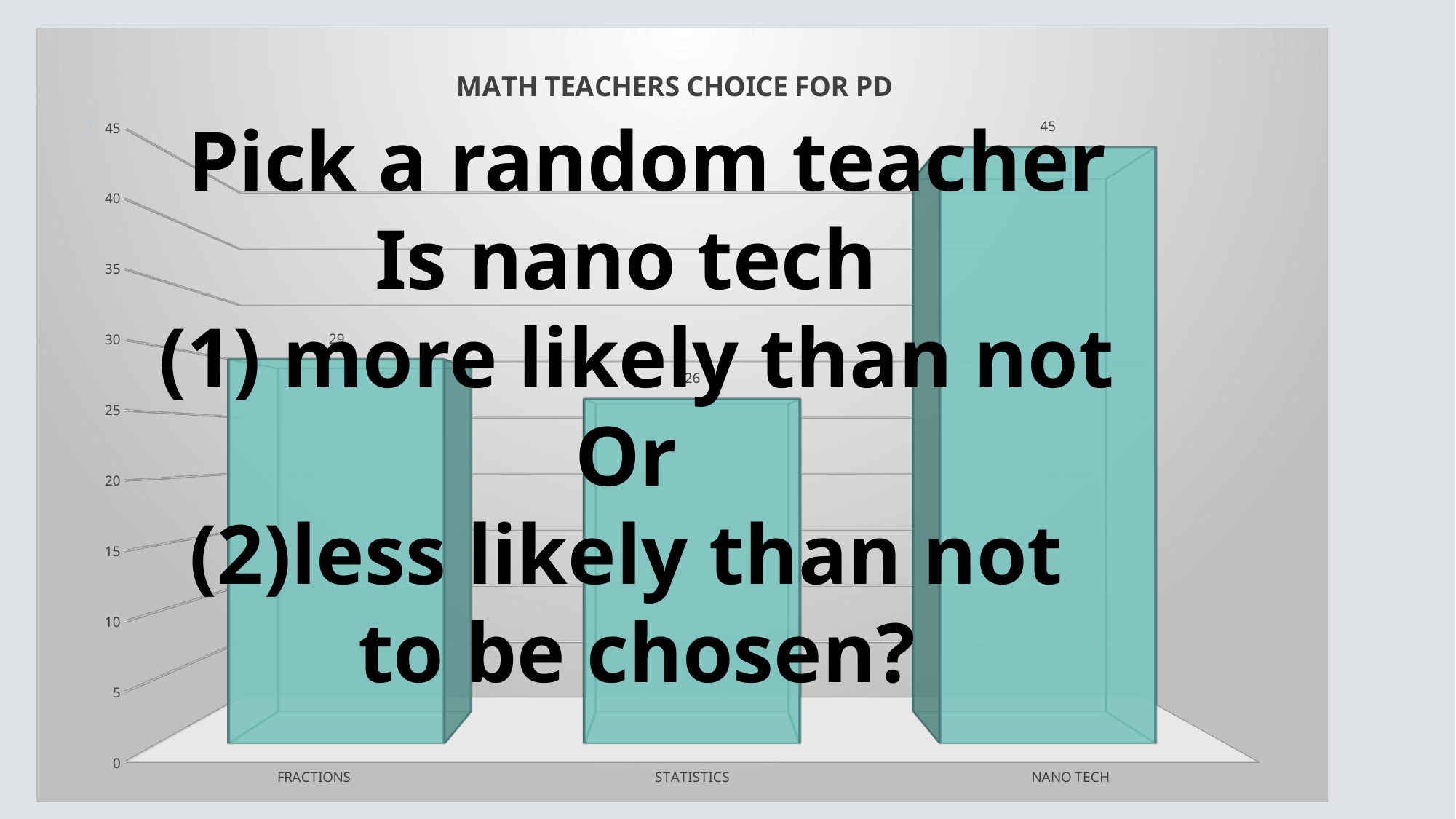
Which category has the lowest value? Statistics Which is larger, the value for Fractions or the value for Statistics? Fractions What is the difference between the values for Nano Tech and Fractions? 16 What is the title of the chart? MATH TEACHERS CHOICE FOR PD What is the value for Statistics? 26 Which category has the highest value? Nano Tech What is the value for Nano Tech? 45 What is the difference between the values for Fractions and Statistics? 3 Is the value for Nano Tech greater or less than 40? greater How many categories are shown on the chart? 3 What kind of chart is shown on the slide? Bar chart What is the value for Fractions? 29